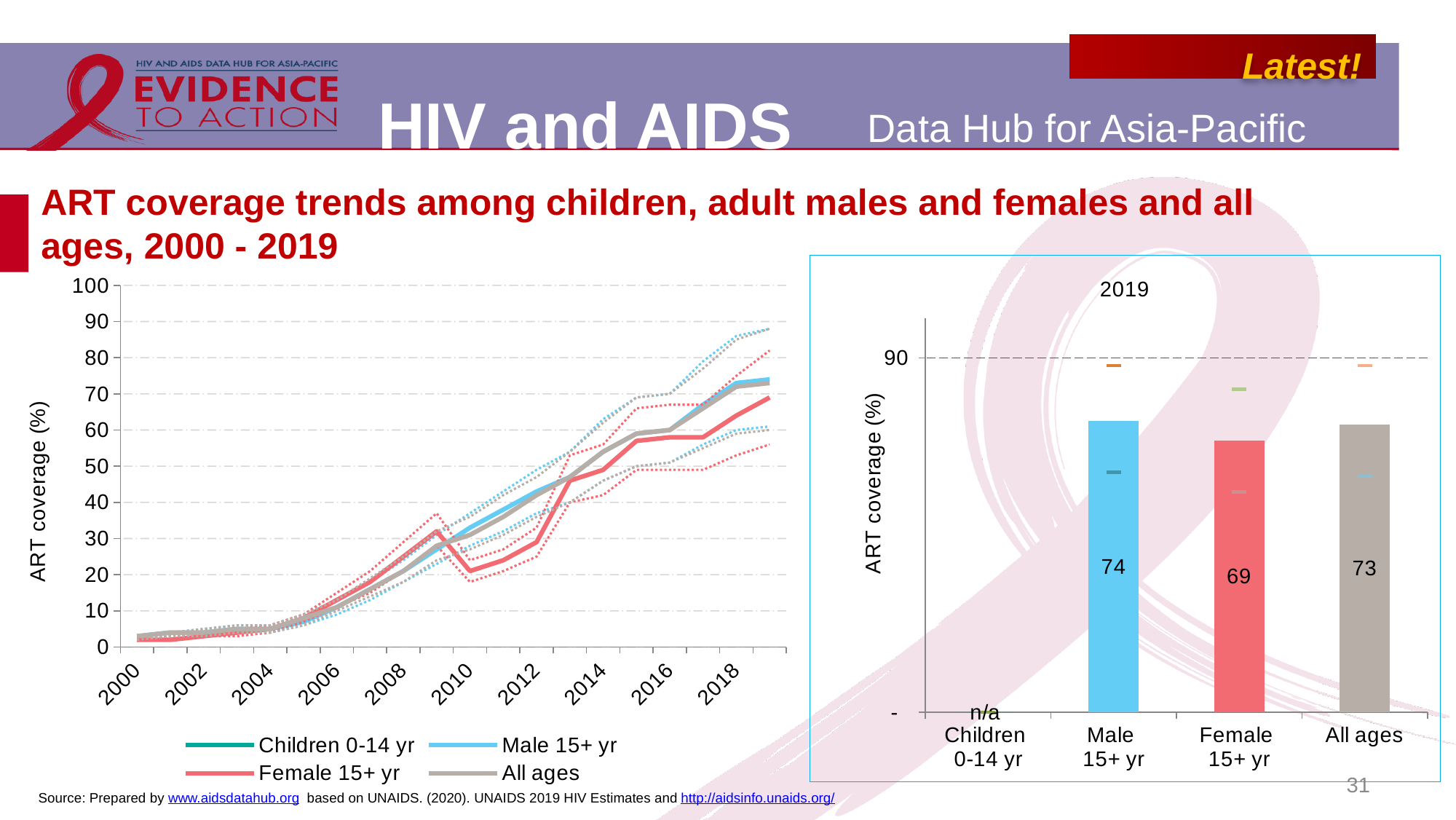
What kind of chart is the chart on the right of the slide, titled 2019? bar chart What kind of chart is the chart on the left of the slide? line chart In the right-hand chart titled 2019, which category has the highest ART coverage? Male 15+ yr In the left-hand line chart, is the value for Female 15+ yr in 2010 greater or less than 30? less In the left-hand line chart, do the ART coverage values generally rise or fall from 2000 to 2019? rise In the right-hand chart titled 2019, how many categories are shown on the x axis? 4 In the left-hand line chart, is the value for Male 15+ yr in 2016 greater or less than 50? greater In the right-hand chart titled 2019, what is the ART coverage value for Male 15+ yr? 74 In the right-hand chart titled 2019, what is shown for Children 0-14 yr? n/a In the right-hand chart titled 2019, what is the difference between the values for Male 15+ yr and Female 15+ yr? 5 In the right-hand chart titled 2019, what is the ART coverage value for Female 15+ yr? 69 How many series does the legend of the left-hand line chart list? 4